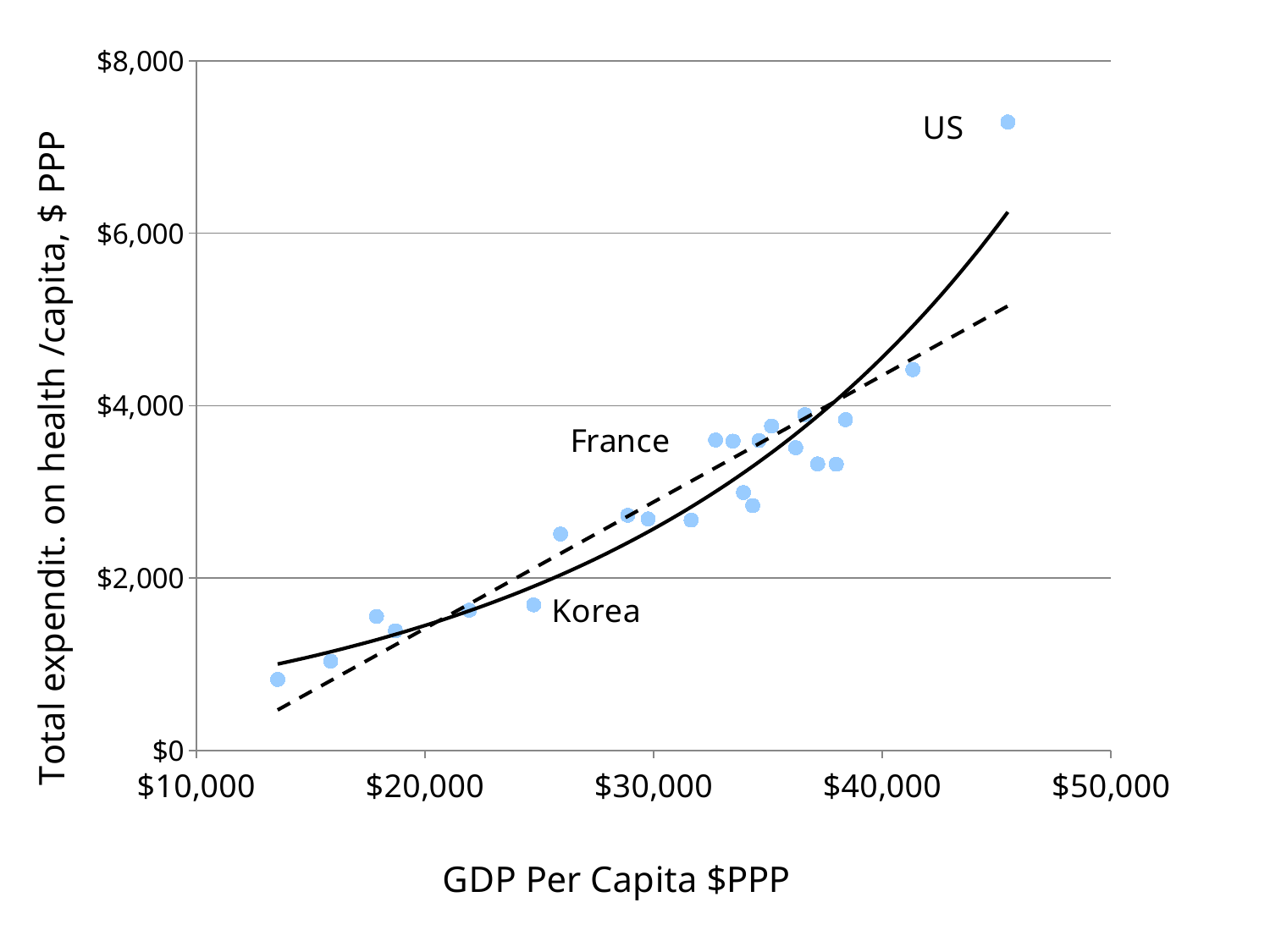
Which labeled country has the highest total expenditure on health per capita? US Is the total expenditure on health per capita for France greater or less than $2,000? greater Do the plotted values generally rise or fall as GDP per capita increases? rise What kind of chart is shown on the slide? scatter chart Is the GDP per capita for the US greater or less than $40,000? greater What is the title of the x axis? GDP Per Capita $PPP Which has a higher total expenditure on health per capita, the US or France? US Is the total expenditure on health per capita for Korea greater or less than $2,000? less Which has a higher total expenditure on health per capita, the US or Korea? US How many countries are labeled by name on the chart? 3